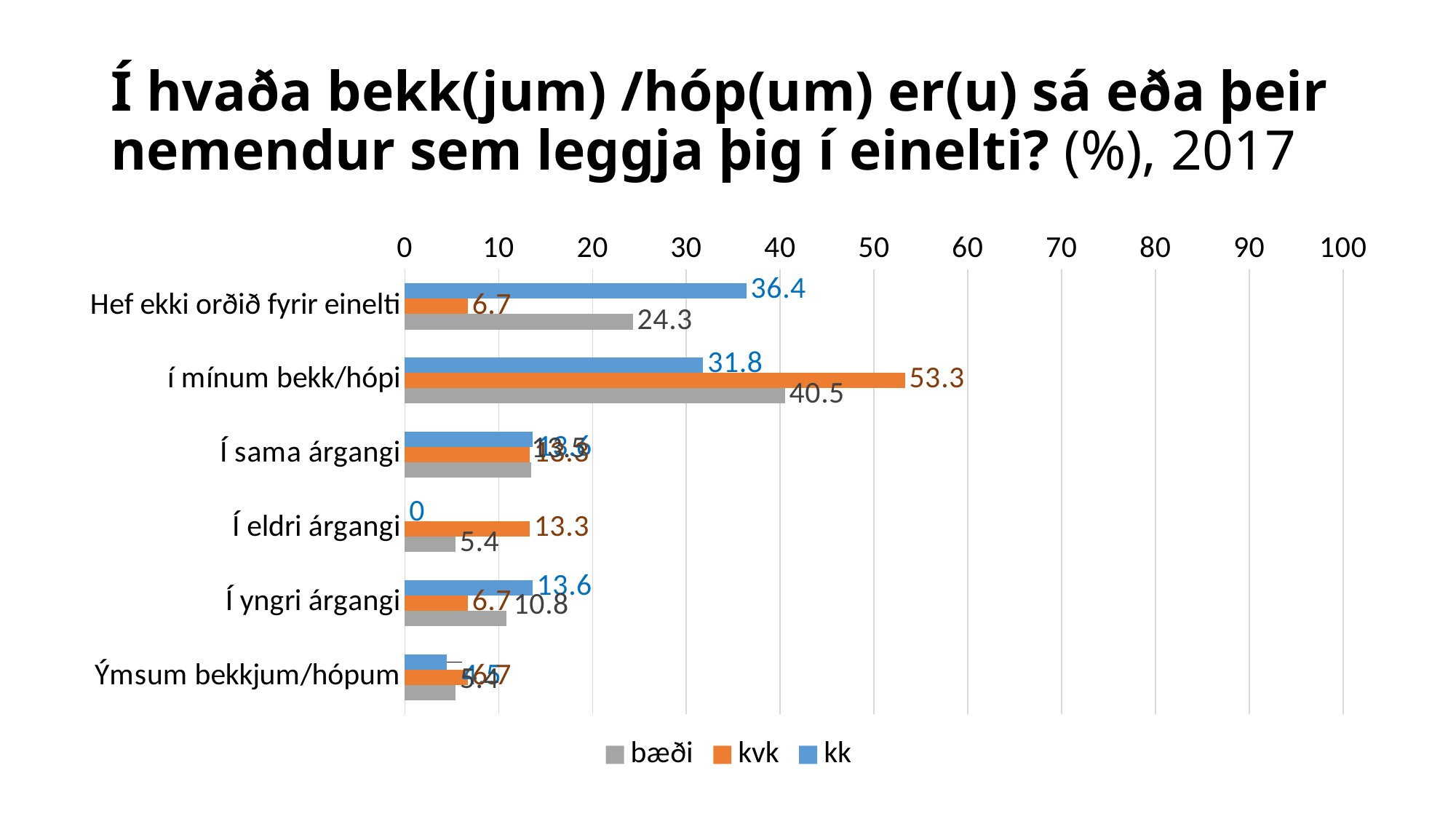
For "Hef ekki orðið fyrir einelti", which is larger: the kk value or the kvk value? kk What kind of chart is shown on the slide? bar chart What is the kvk value for "í mínum bekk/hópi"? 53.3 How many categories are shown on the chart? 6 Which category has the highest kvk value? í mínum bekk/hópi What is the bæði value for "í mínum bekk/hópi"? 40.5 What is the kk value for "Hef ekki orðið fyrir einelti"? 36.4 Which category has the highest kk value? Hef ekki orðið fyrir einelti What is the kk value for "Í eldri árgangi"? 0 How many series does the legend list? 3 What is the bæði value for "Í yngri árgangi"? 10.8 For "í mínum bekk/hópi", how much larger is the kvk value than the kk value? 21.5